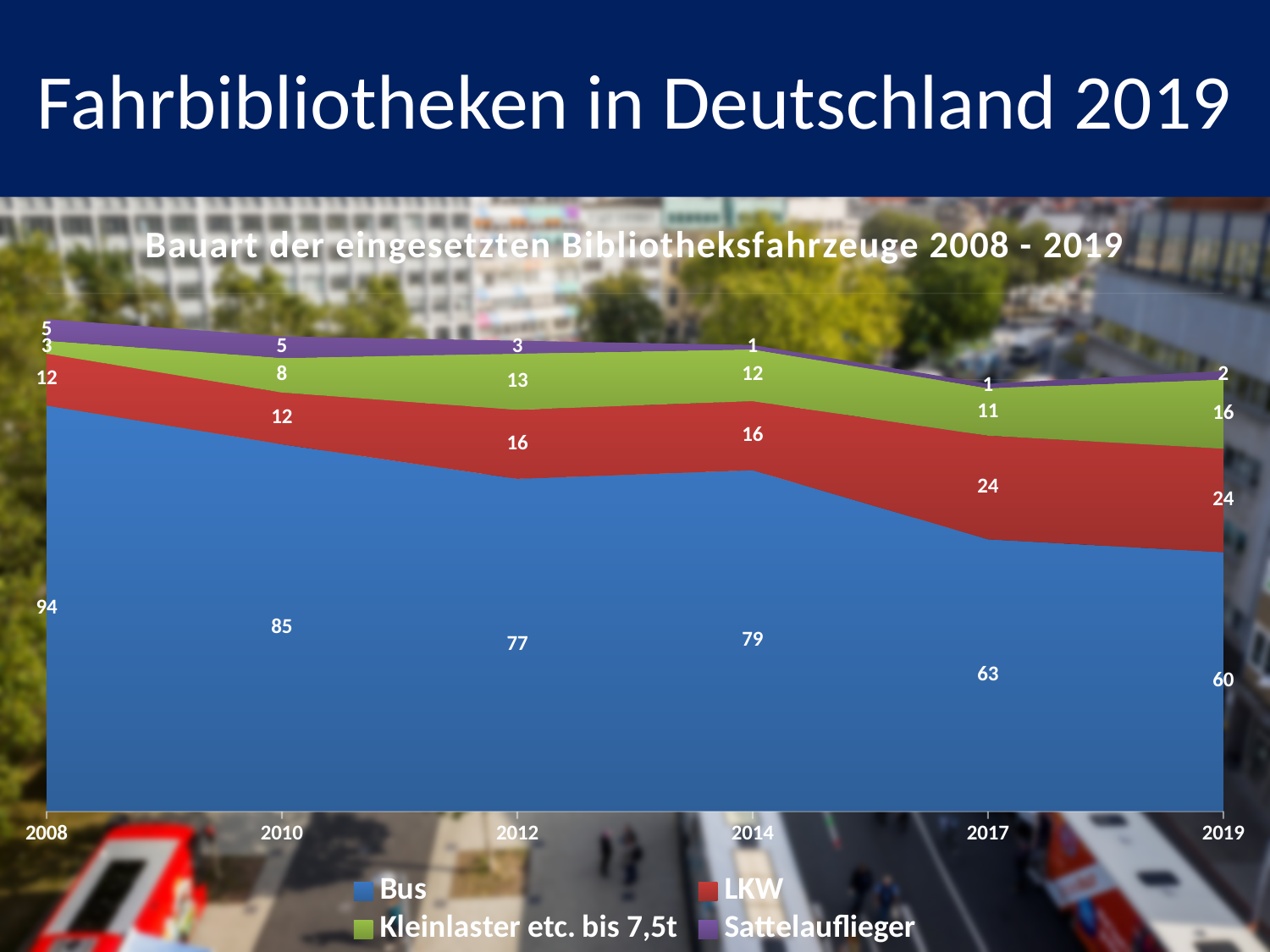
In which year is the Bus value lowest? 2019 How many years are shown on the x axis? 6 What is the value for Kleinlaster etc. bis 7,5t in 2012? 13 What kind of chart is shown on the slide? stacked area chart What is the value for Bus in 2008? 94 Which is larger, the LKW value in 2012 or the LKW value in 2019? 2019 What is the title of the chart? Bauart der eingesetzten Bibliotheksfahrzeuge 2008 - 2019 What is the difference between the Bus value in 2008 and in 2019? 34 How many series does the legend list? 4 What is the total of all four series in 2019? 102 What is the value for LKW in 2017? 24 What is the value for Sattelauflieger in 2019? 2